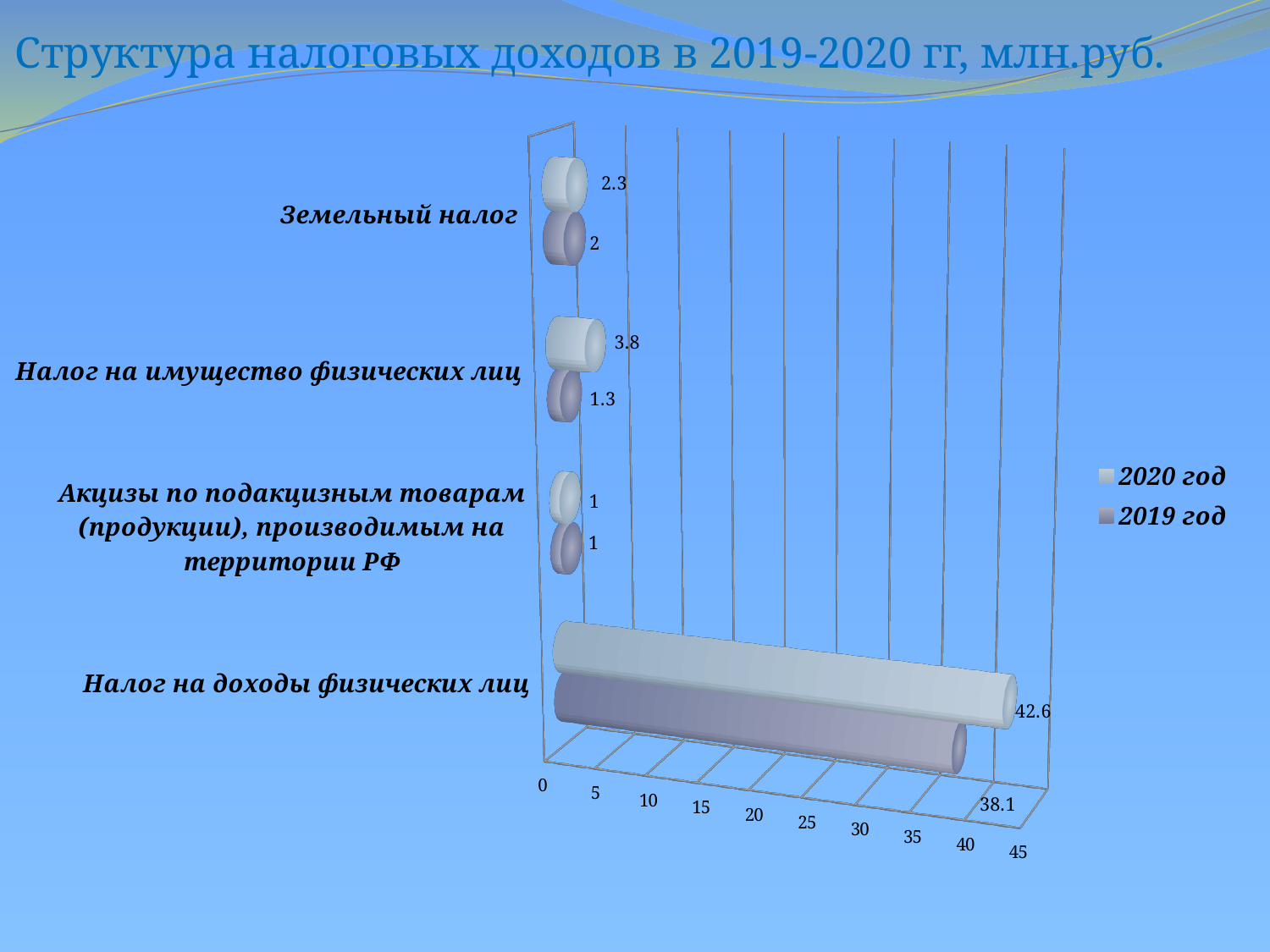
What is the value for Земельный налог in the 2019 год series? 2 Which category has the highest value in the 2020 год series? Налог на доходы физических лиц How many series does the legend list? 2 What is the difference between the 2020 год and 2019 год values for Налог на доходы физических лиц? 4.5 For Налог на имущество физических лиц, which series has the larger value, 2020 год or 2019 год? 2020 год Is the 2019 год value for Налог на доходы физических лиц greater or less than 35? greater What is the value for Налог на доходы физических лиц in the 2019 год series? 38.1 Which category has the lowest value in the 2019 год series? Акцизы по подакцизным товарам (продукции), производимым на территории РФ What kind of chart is shown on the slide? Bar chart What is the value for Налог на имущество физических лиц in the 2020 год series? 3.8 How many categories are shown on the chart? 4 What is the value for Налог на доходы физических лиц in the 2020 год series? 42.6